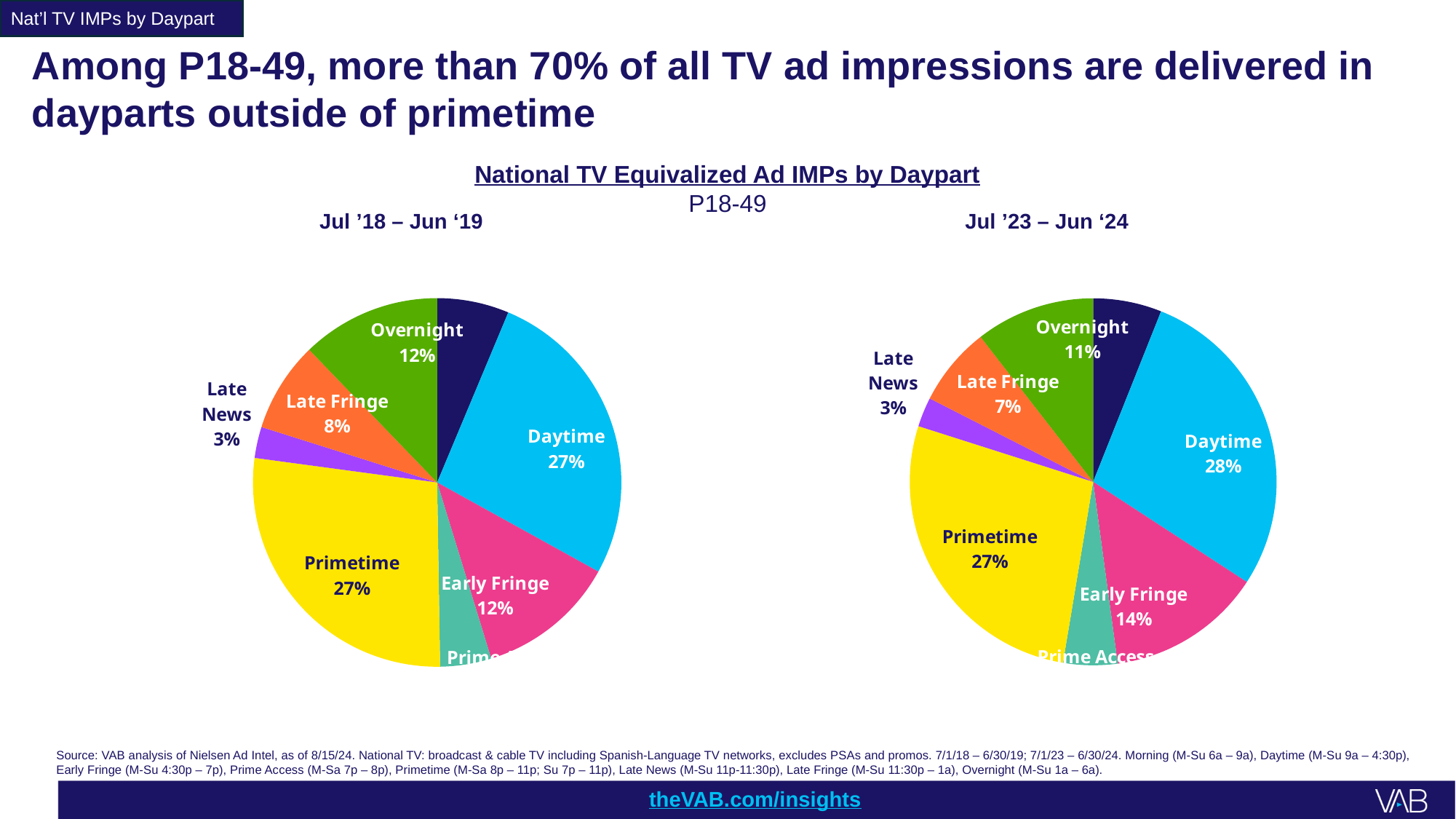
In the Jul '23 – Jun '24 pie chart, what is the value for Early Fringe? 14% In the Jul '23 – Jun '24 pie chart, which daypart has the largest share? Daytime In the Jul '23 – Jun '24 pie chart, which is larger, Late Fringe or Overnight? Overnight In the Jul '18 – Jun '19 pie chart, which labeled daypart has the smallest share? Late News What type of chart is used on this slide? Pie chart How many slices does the Jul '18 – Jun '19 pie chart have? 8 What is the difference between the Early Fringe share in Jul '23 – Jun '24 and in Jul '18 – Jun '19? 2 percentage points In the Jul '18 – Jun '19 pie chart, what is the value for Late Fringe? 8% In the Jul '23 – Jun '24 pie chart, what share of ad impressions is Daytime? 28% In the Jul '23 – Jun '24 pie chart, what is the value for Overnight? 11% In the Jul '18 – Jun '19 pie chart, what share of ad impressions is Daytime? 27% What is the title shown above the two pie charts? National TV Equivalized Ad IMPs by Daypart